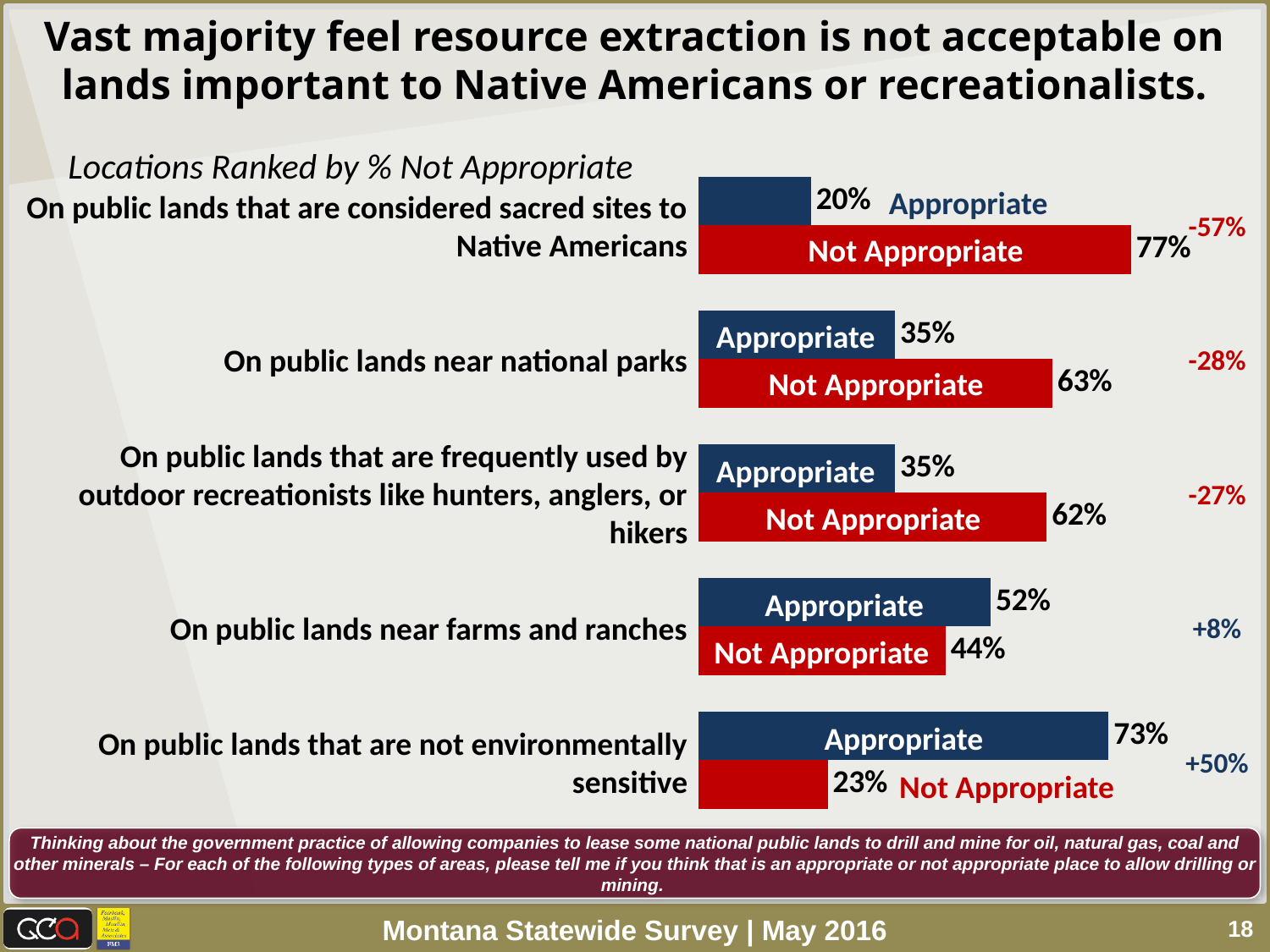
What percentage say resource extraction is not appropriate on public lands that are considered sacred sites to Native Americans? 77% What percentage say resource extraction is not appropriate on public lands near national parks? 63% Which location has the highest Not Appropriate percentage? On public lands that are considered sacred sites to Native Americans What colour are the Not Appropriate bars? Red Which is larger for public lands near farms and ranches: the Appropriate or the Not Appropriate percentage? Appropriate What percentage say resource extraction is appropriate on public lands near farms and ranches? 52% What percentage say resource extraction is appropriate on public lands that are not environmentally sensitive? 73% Which location has the lowest Appropriate percentage? On public lands that are considered sacred sites to Native Americans What is the difference between the Not Appropriate and Appropriate percentages for public lands near national parks? 28% What kind of chart is shown on the slide? Bar chart How many locations are shown in the chart? 5 What is the net figure shown at the right for public lands that are not environmentally sensitive? +50%